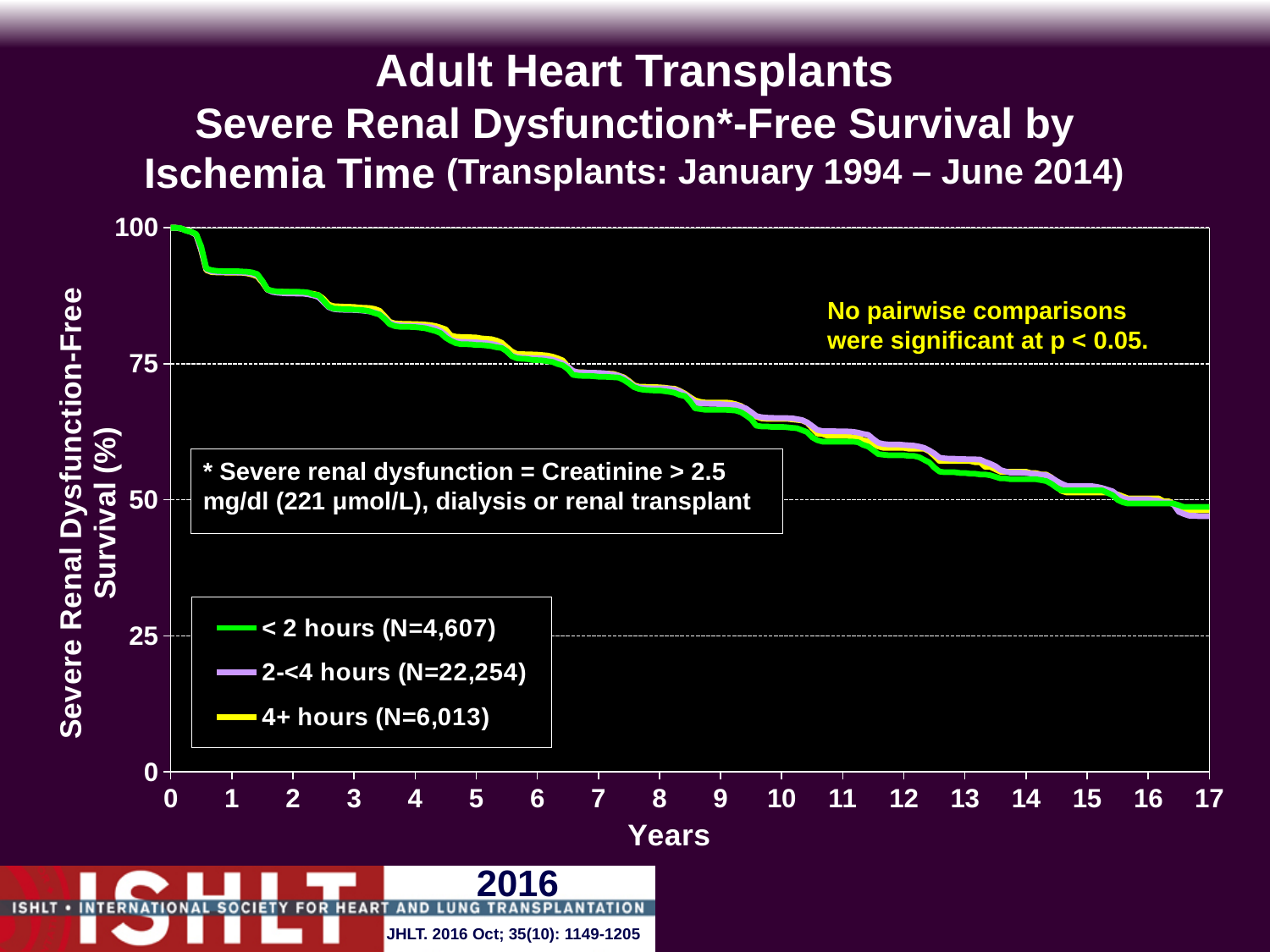
What is the label of the x axis? Years Is the severe renal dysfunction-free survival for the 2-<4 hours group at year 3 greater or less than 75? greater What is the N for the 2-<4 hours group shown in the legend? N=22,254 What is the highest value shown on the x axis? 17 Is the severe renal dysfunction-free survival for the 4+ hours group at year 12 greater or less than 75? less How many series does the legend list? 3 Do the survival curves rise or fall as years increase? fall Is the severe renal dysfunction-free survival for the < 2 hours group at year 10 greater or less than 50? greater What kind of chart is shown on the slide? line chart